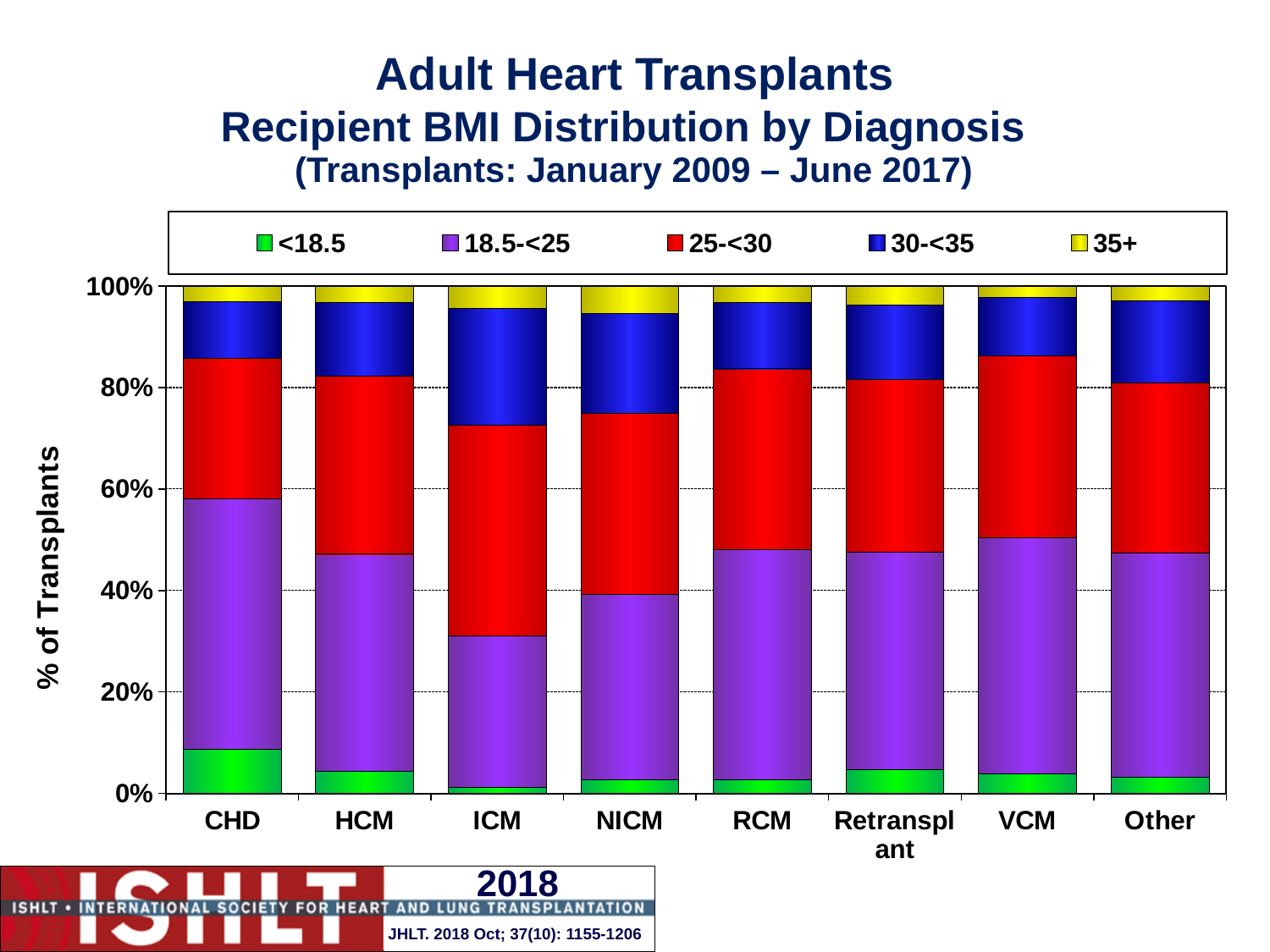
What is the label of the y axis? % of Transplants Which BMI category is shown in green in the legend? <18.5 Is the 18.5-<25 BMI share for CHD greater or less than 40%? greater Which diagnosis has the largest <18.5 BMI segment? CHD Which diagnosis has the largest 25-<30 BMI segment? ICM Is the 18.5-<25 BMI segment larger for CHD or for ICM? CHD How many diagnosis categories are shown on the x axis? 8 What do the stacked segments of each bar add up to? 100% What kind of chart is shown on the slide? stacked bar chart Is the 18.5-<25 BMI share for ICM greater or less than 40%? less Which diagnosis has the smallest <18.5 BMI segment? ICM How many BMI series does the legend list? 5